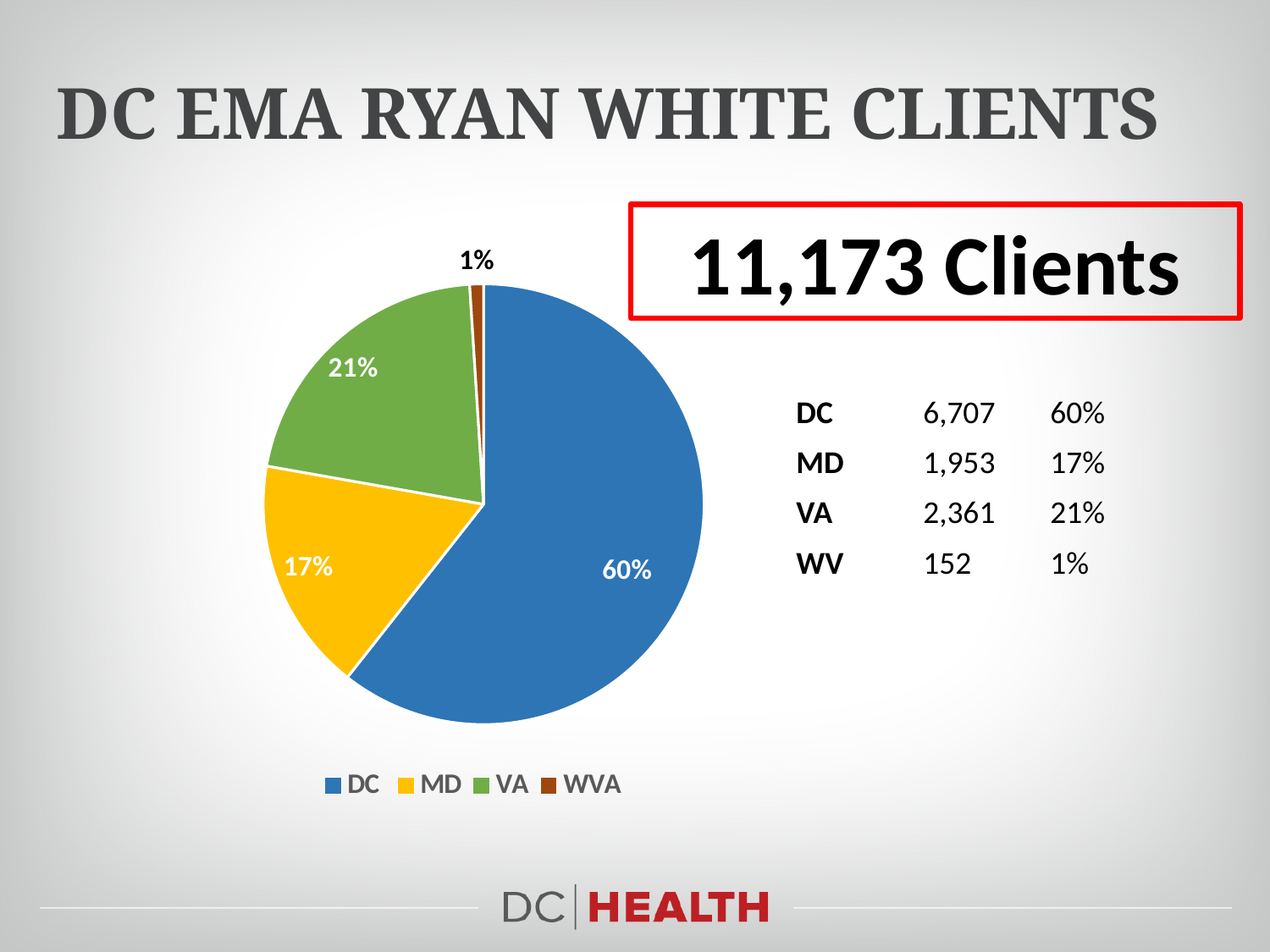
How many slices does the pie chart have? 4 What kind of chart is shown on the slide? pie chart How many entries does the legend list? 4 Which category has the smallest slice of the pie? WVA Which slice is larger, VA or MD? VA Which category has the largest slice of the pie? DC What percentage of the pie does the MD slice represent? 17% What colour is the DC slice in the pie chart? blue What is the difference in percentage points between the DC slice and the VA slice? 39 What percentage of the pie does the DC slice represent? 60% What percentage of the pie does the WVA slice represent? 1%